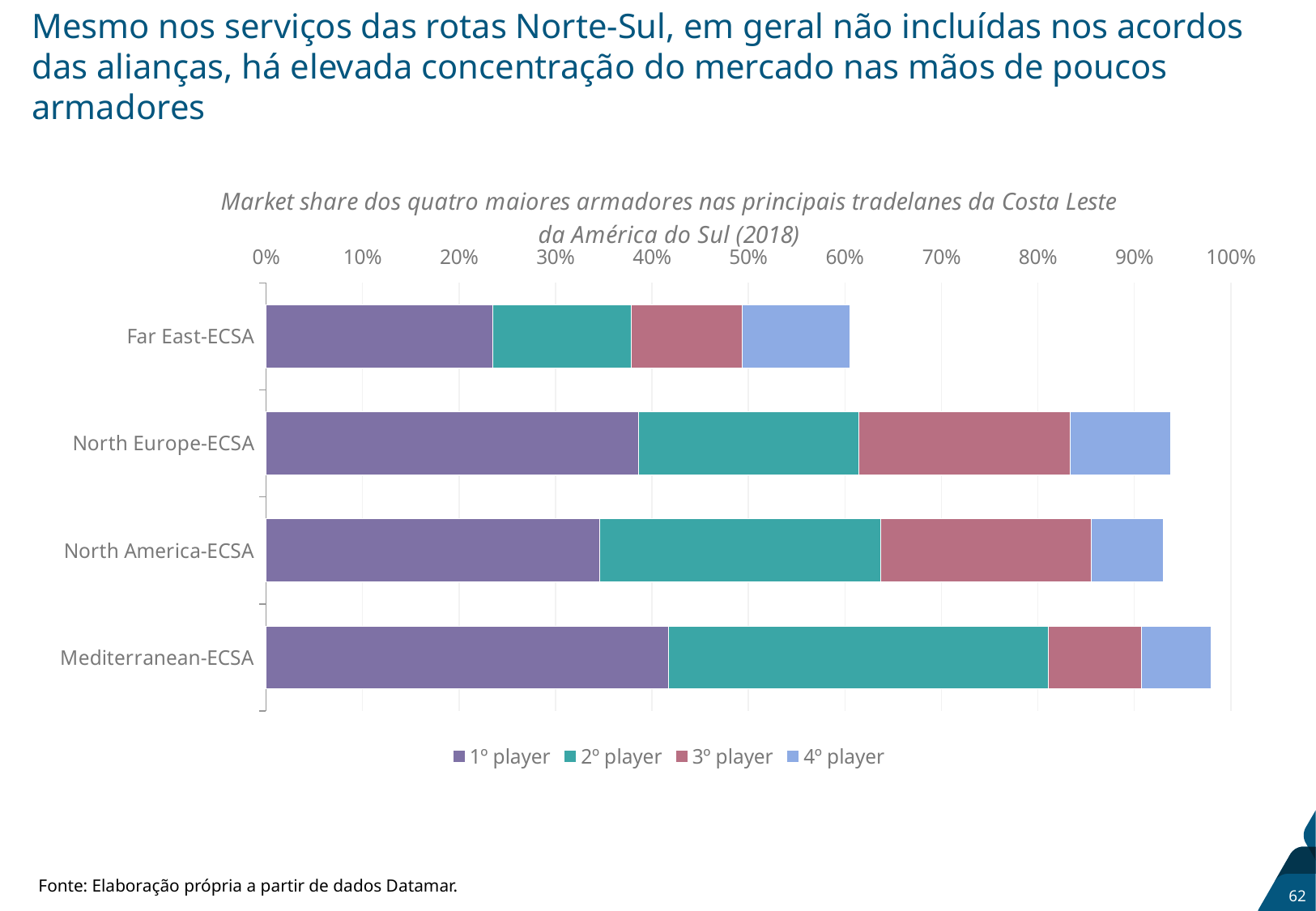
What kind of chart is shown on the slide? Stacked bar chart Is the 1º player share for North Europe-ECSA greater or less than 30%? greater Which is larger: the 2º player segment for Mediterranean-ECSA or for Far East-ECSA? Mediterranean-ECSA Is the 1º player share for Far East-ECSA greater or less than 30%? less How many series does the legend list? 4 Which tradelane has the smallest 1º player segment? Far East-ECSA Which tradelane has the longest total bar (highest combined market share of the four largest carriers)? Mediterranean-ECSA Is the total bar for Mediterranean-ECSA greater or less than 90%? greater What year does the chart title say the market share data refers to? 2018 Which tradelane has the shortest total bar (lowest combined market share of the four largest carriers)? Far East-ECSA How many tradelanes (categories) are shown in the chart? 4